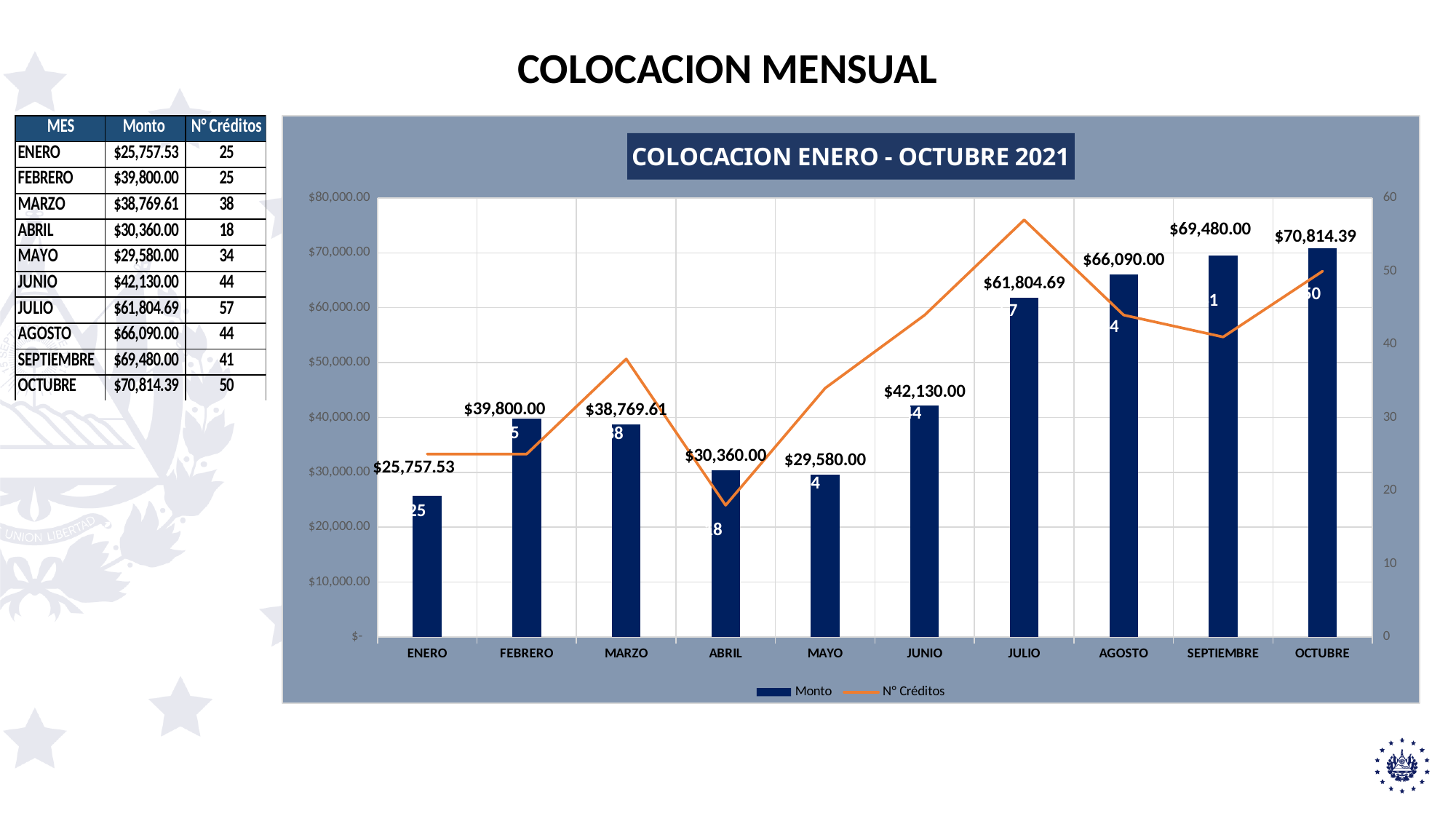
Is the Monto for AGOSTO greater or less than $60,000.00? greater What is the title of the chart? COLOCACION ENERO - OCTUBRE 2021 Which month has the highest Monto? OCTUBRE Which has a larger Monto, FEBRERO or MARZO? FEBRERO What kind of chart is used to show the Monto series? bar chart What is the Monto value for ENERO? $25,757.53 What is the difference in Monto between OCTUBRE and SEPTIEMBRE? $1,334.39 Does the Monto rise or fall from JUNIO to OCTUBRE? rise Which month has the lowest Monto? ENERO How many series does the chart legend list? 2 What is the Monto value for JULIO? $61,804.69 How many months are shown on the x axis of the chart? 10